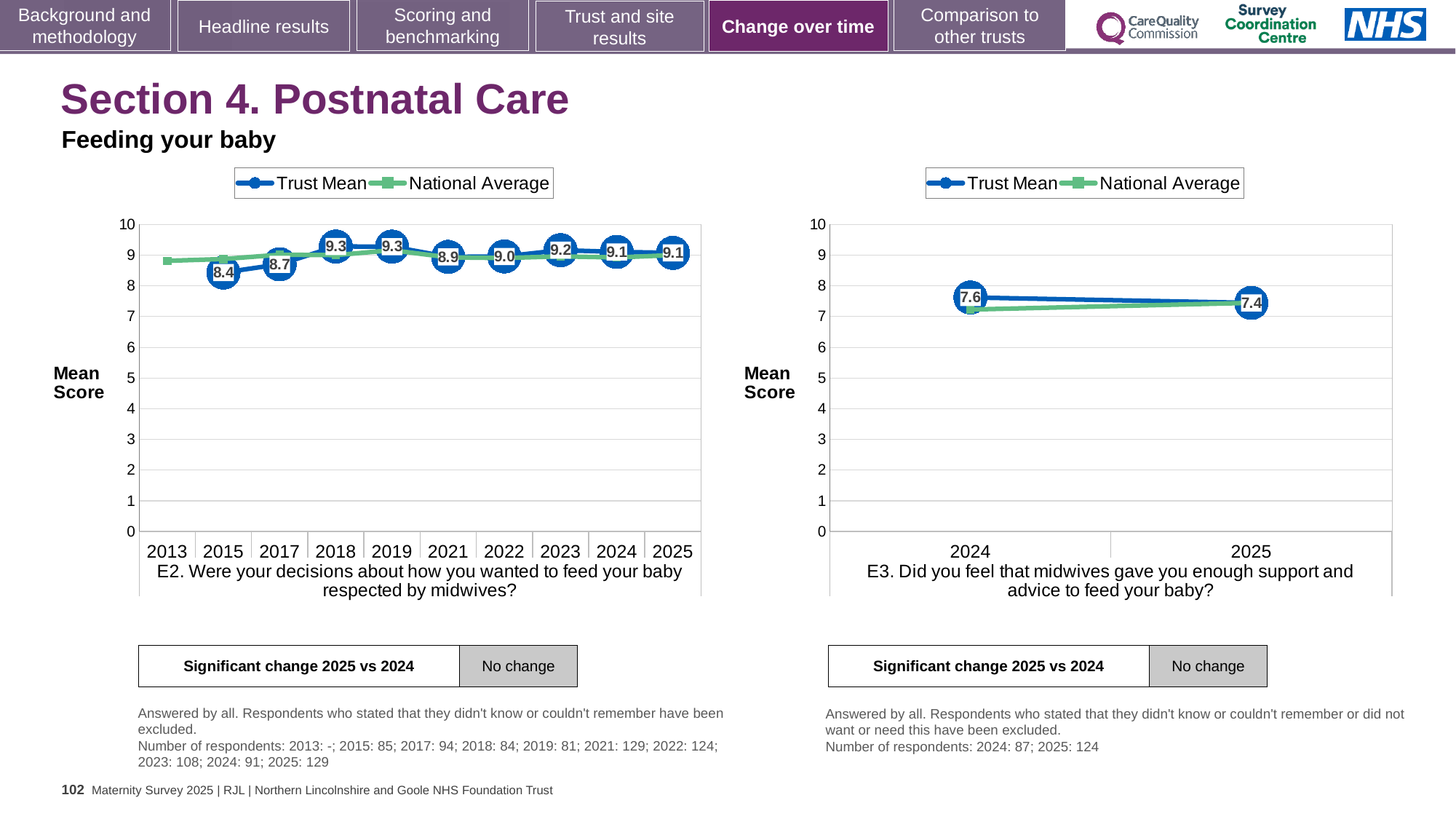
How many series does the legend of the right chart (E3) list? 2 How many years are shown on the x axis of the left chart (E2)? 10 On the left chart (E2), is the National Average for 2013 greater or less than 8? greater What kind of chart is the right chart (E3)? Line chart On the right chart (E3), does the Trust Mean rise or fall from 2024 to 2025? Fall On the left chart (E2), what is the difference between the Trust Mean for 2018 and 2015? 0.9 On the left chart (E2), which is larger, the Trust Mean for 2017 or for 2021? 2021 On the right chart (E3), what is the Trust Mean for 2024? 7.6 On the right chart (E3), what is the difference between the Trust Mean for 2024 and 2025? 0.2 On the left chart (E2), what is the Trust Mean for 2025? 9.1 On the left chart (E2), which year has the lowest Trust Mean? 2015 On the left chart (E2), what is the Trust Mean for 2015? 8.4